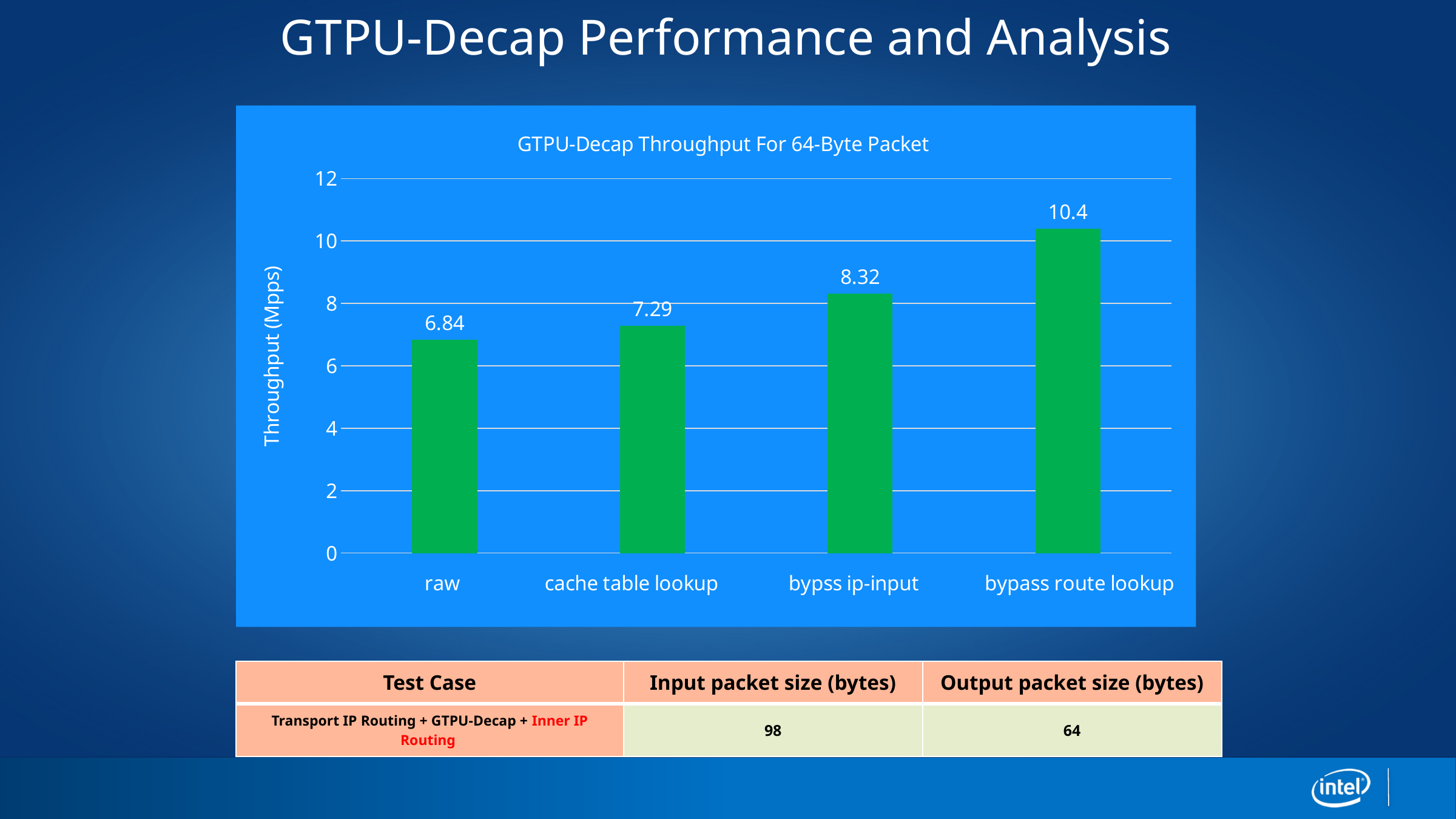
How many categories are shown on the x axis? 4 Is the value for bypass route lookup greater or less than 10? greater What kind of chart is shown? bar chart What is the throughput for cache table lookup? 7.29 What is the throughput for raw? 6.84 What is the difference in throughput between bypass route lookup and raw? 3.56 Which category has the lowest throughput? raw Do the values rise or fall from left to right along the x axis? rise What is the throughput for bypass route lookup? 10.4 Which has a higher throughput, cache table lookup or bypss ip-input? bypss ip-input What is the throughput for bypss ip-input? 8.32 Which category has the highest throughput? bypass route lookup